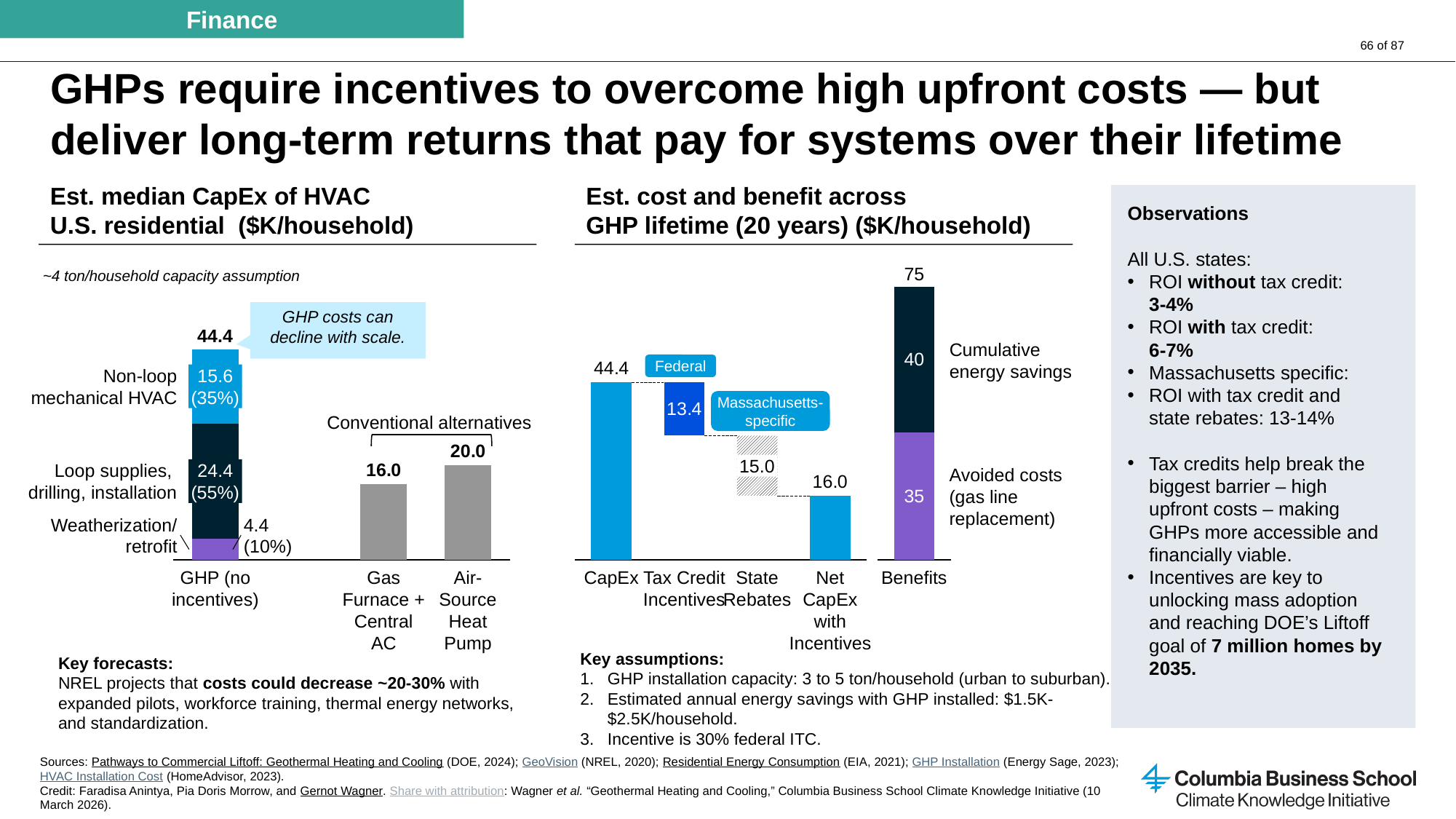
In the 'Est. median CapEx of HVAC U.S. residential' chart, what is the difference between the GHP (no incentives) total and the Air-Source Heat Pump value? 24.4 In the 'Est. median CapEx of HVAC U.S. residential' chart, what percentage of the GHP CapEx is Non-loop mechanical HVAC? 35% In the 'Est. cost and benefit across GHP lifetime' chart, which is larger: Cumulative energy savings or Avoided costs (gas line replacement)? Cumulative energy savings In the 'Est. cost and benefit across GHP lifetime' chart, what label is attached to the Tax Credit Incentives step? Federal In the 'Est. cost and benefit across GHP lifetime' chart, what is the value for Net CapEx with Incentives? 16.0 In the 'Est. cost and benefit across GHP lifetime' chart, what is the total of the Benefits bar? 75 In the 'Est. median CapEx of HVAC U.S. residential' chart, what is the value of the Loop supplies, drilling, installation segment of the GHP bar? 24.4 In the 'Est. cost and benefit across GHP lifetime' chart, what is the value of the State Rebates step? 15.0 In the 'Est. median CapEx of HVAC U.S. residential' chart, which category has the lowest CapEx? Gas Furnace + Central AC In the 'Est. median CapEx of HVAC U.S. residential' chart, what is the value for the Air-Source Heat Pump? 20.0 In the 'Est. median CapEx of HVAC U.S. residential' chart, what is the total CapEx for GHP (no incentives)? 44.4 In the 'Est. median CapEx of HVAC U.S. residential' chart, how many categories are shown on the x axis? 3